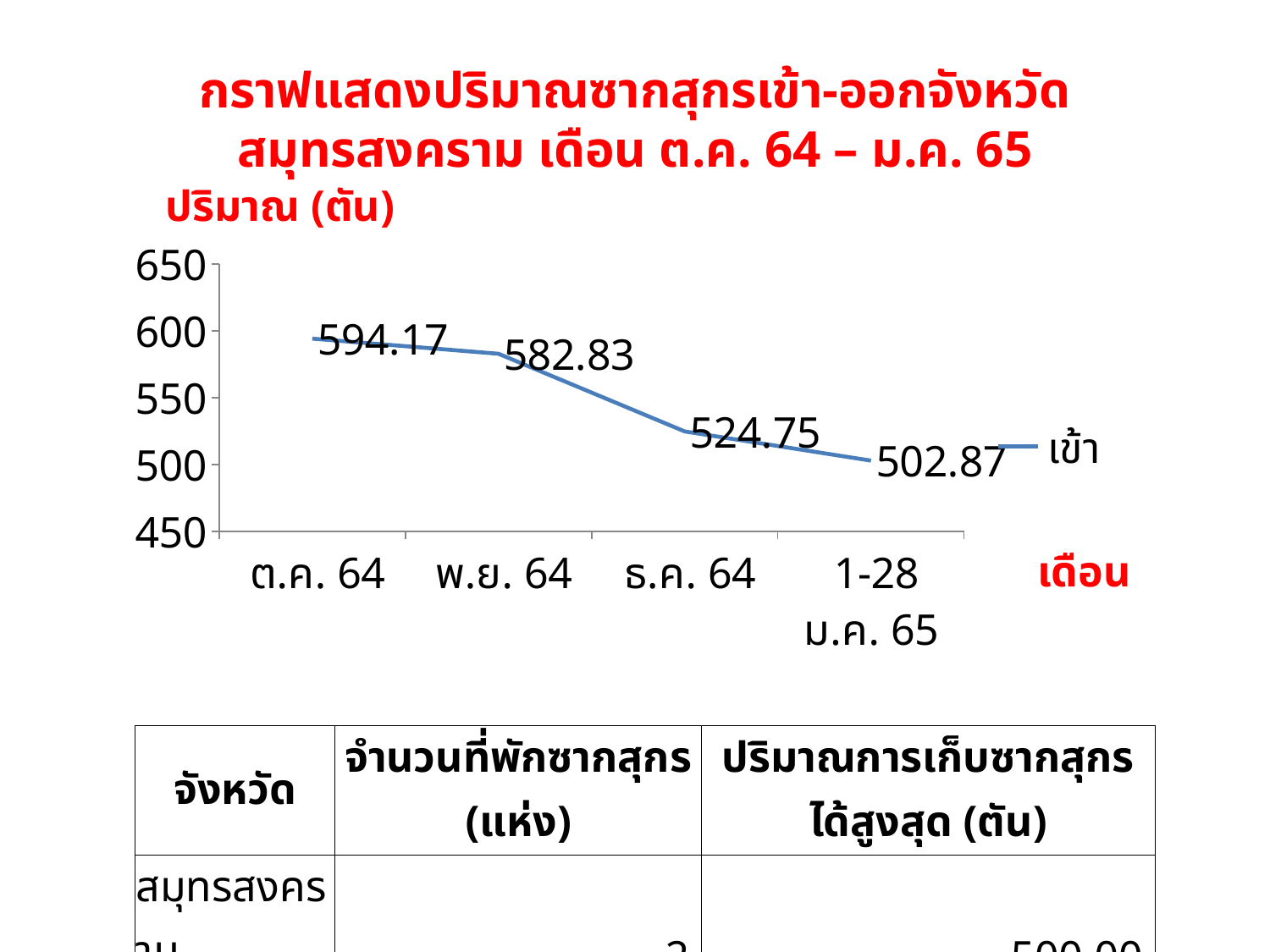
What is the value for ธ.ค. 64? 524.75 What is the value for พ.ย. 64? 582.83 Do the values rise or fall from ต.ค. 64 to 1-28 ม.ค. 65? fall Which month has the lowest value? 1-28 ม.ค. 65 Which month has the highest value? ต.ค. 64 Which is larger, the value for พ.ย. 64 or the value for ธ.ค. 64? พ.ย. 64 What kind of chart is shown on the slide? line chart How many data points are plotted on the chart? 4 What is the value for ต.ค. 64? 594.17 Is the value for ธ.ค. 64 greater or less than 550? less What is the value for 1-28 ม.ค. 65? 502.87 What is the difference between the values for ต.ค. 64 and 1-28 ม.ค. 65? 91.30